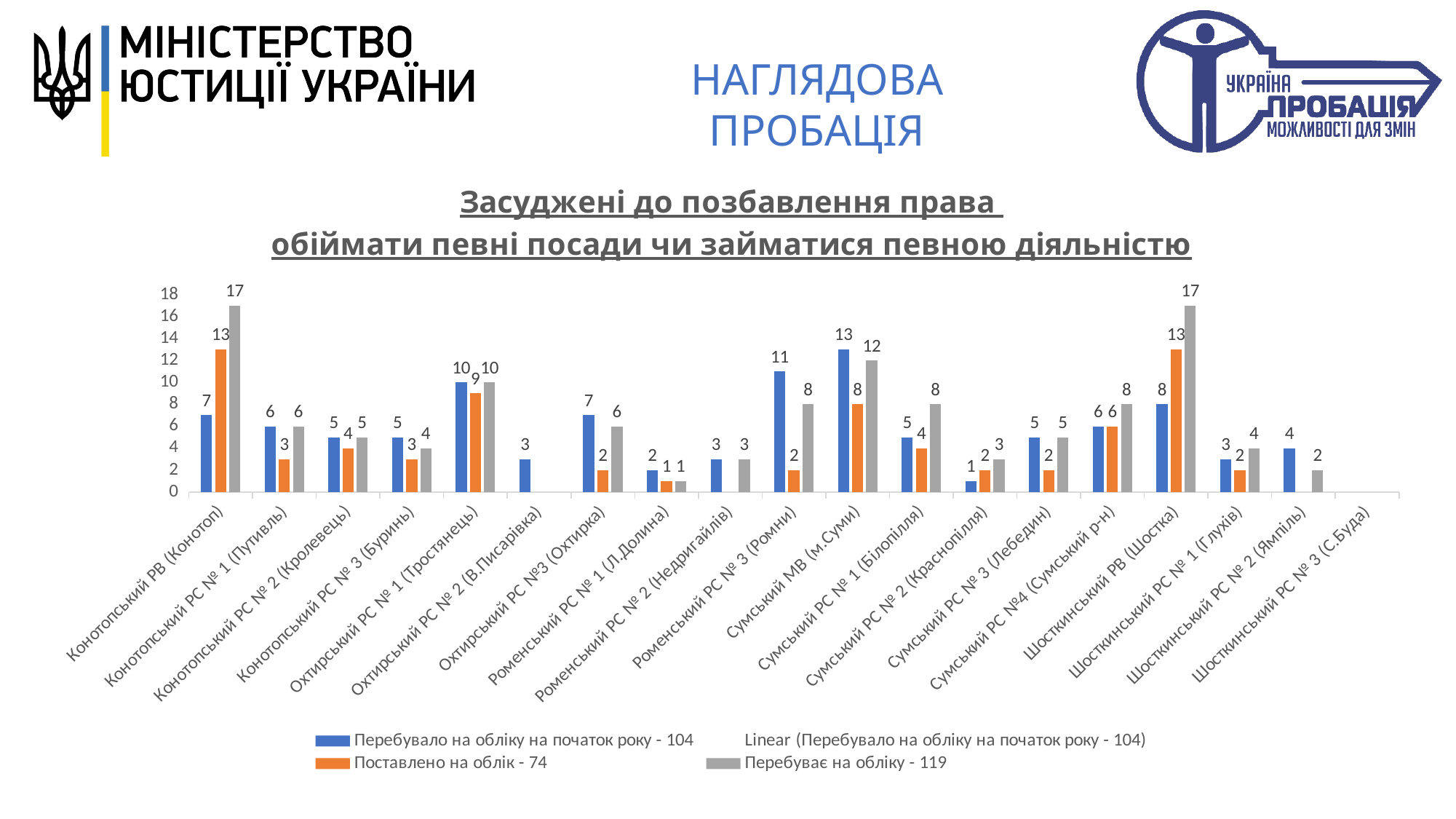
According to the legend, what is the total for 'Перебуває на обліку'? 119 Among the categories with a labelled bar, which has the lowest value for 'Перебувало на обліку на початок року'? Сумський РС № 2 (Краснопілля) For Шосткинський РВ (Шостка), which is larger: 'Поставлено на облік' or 'Перебувало на обліку на початок року'? Поставлено на облік What colour are the bars for 'Поставлено на облік'? Orange What is the value of 'Поставлено на облік' for Сумський МВ (м.Суми)? 8 What is the value of 'Перебувало на обліку на початок року' for Роменський РС № 3 (Ромни)? 11 For Конотопський РВ (Конотоп), what is the difference between 'Перебуває на обліку' and 'Перебувало на обліку на початок року'? 10 What is the value of 'Поставлено на облік' for Охтирський РС № 1 (Тростянець)? 9 Which category has the highest value for 'Перебувало на обліку на початок року'? Сумський МВ (м.Суми) What kind of chart is shown on the slide? Bar chart What is the value of 'Перебуває на обліку' for Конотопський РВ (Конотоп)? 17 How many categories are shown on the x axis of the chart? 19